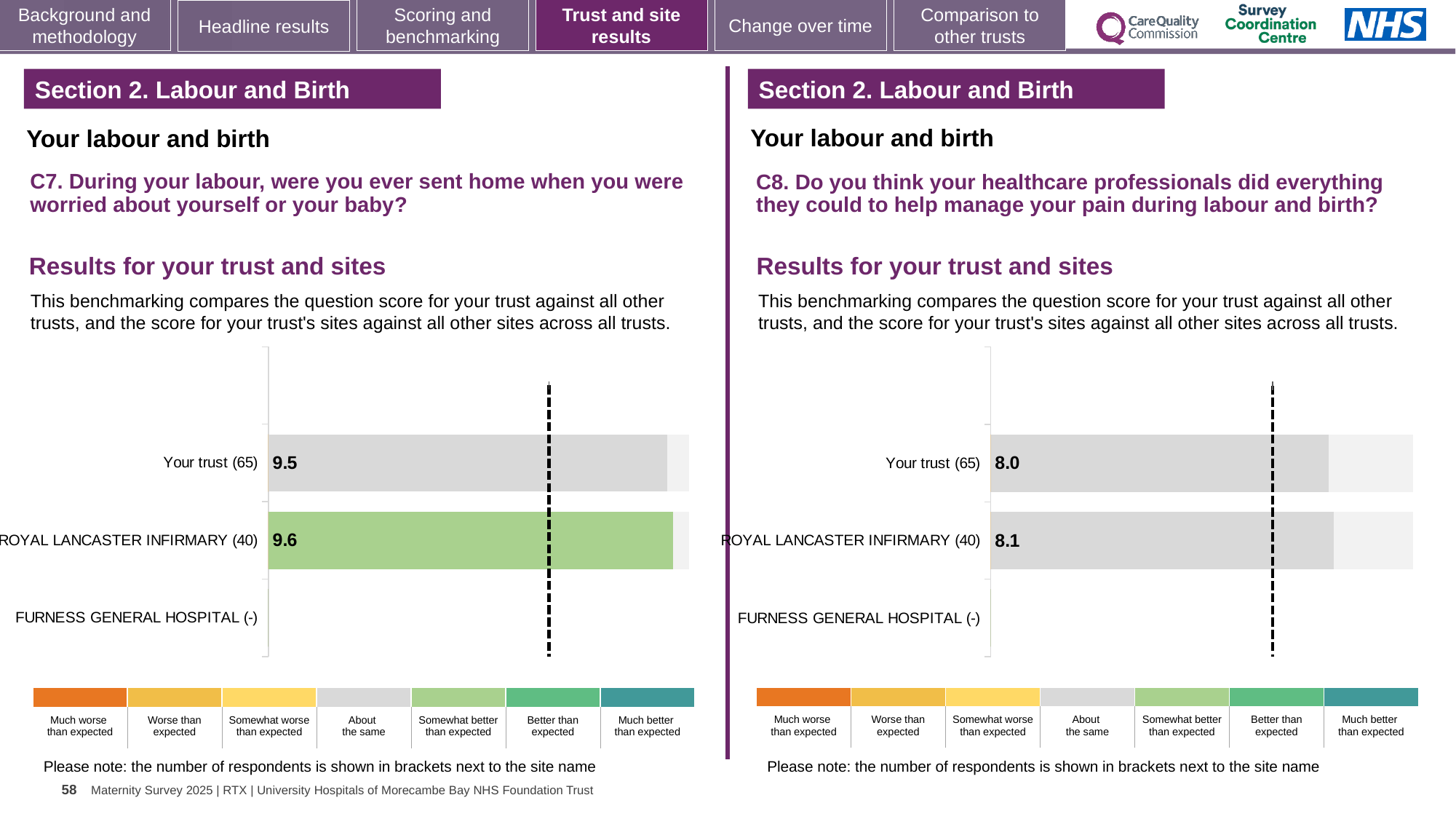
How many site/trust categories are listed on the C7 chart (left)? 3 On the C8 chart (right), what is the score for ROYAL LANCASTER INFIRMARY (40)? 8.1 On the C7 chart (left), what is the score for Your trust (65)? 9.5 On the C7 chart (left), which has the higher score, Your trust or ROYAL LANCASTER INFIRMARY? ROYAL LANCASTER INFIRMARY On the C8 chart (right), what is the difference between the ROYAL LANCASTER INFIRMARY score and the Your trust score? 0.1 On the C8 chart (right), which has the higher score, Your trust or ROYAL LANCASTER INFIRMARY? ROYAL LANCASTER INFIRMARY On the C7 chart (left), which category has no bar plotted? FURNESS GENERAL HOSPITAL (-) On the C7 chart (left), what is the difference between the ROYAL LANCASTER INFIRMARY score and the Your trust score? 0.1 What kind of chart is used on the C8 chart (right)? Bar chart On the C7 chart (left), what is the score for ROYAL LANCASTER INFIRMARY (40)? 9.6 On the C7 chart (left), what colour is the bar for ROYAL LANCASTER INFIRMARY (40)? Green On the C8 chart (right), what is the score for Your trust (65)? 8.0